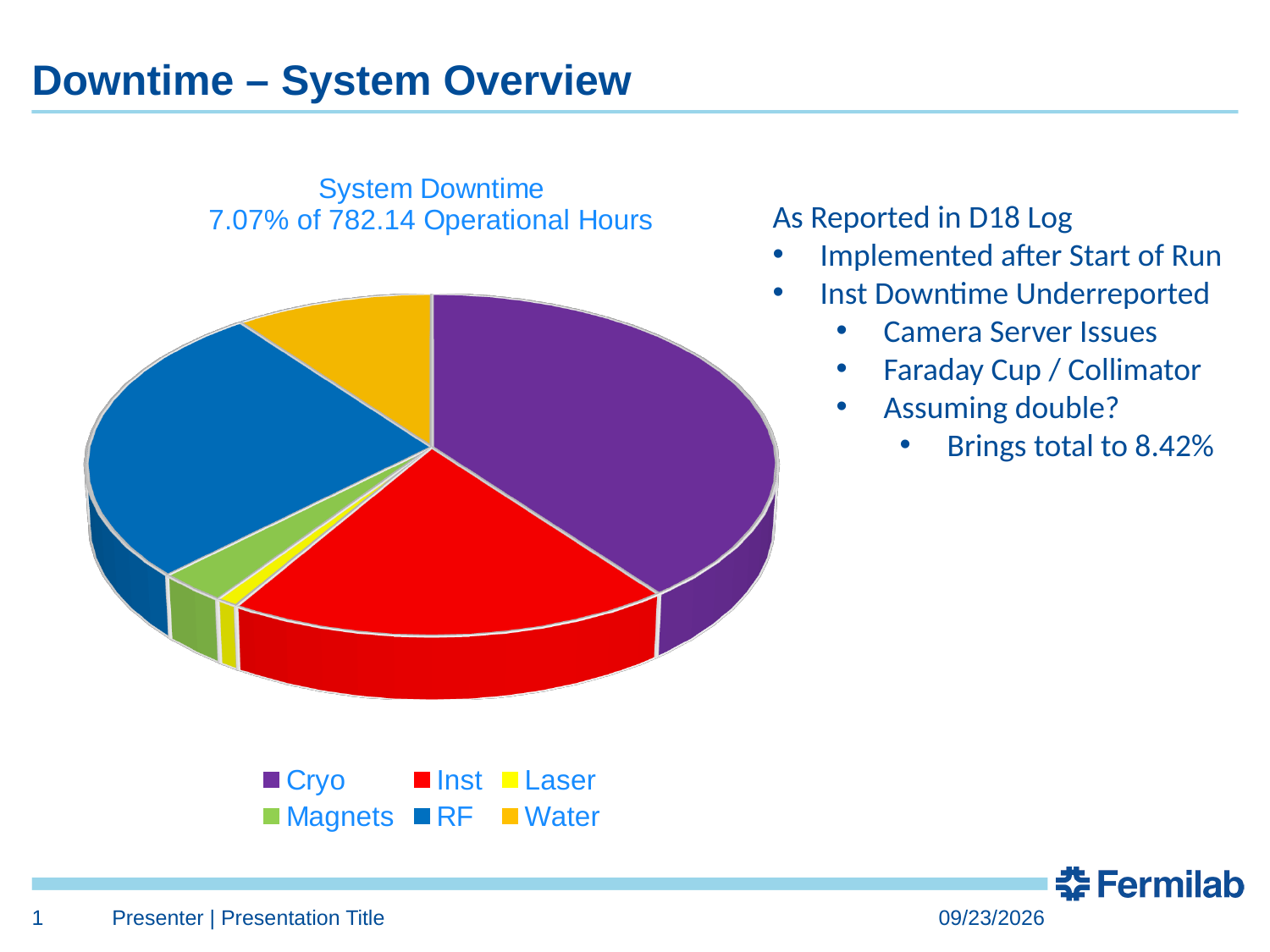
How many categories (slices) does the pie chart have? 6 What is the title of the pie chart? System Downtime 7.07% of 782.14 Operational Hours Which slice is larger in the pie chart, Water or Magnets? Water What kind of chart is shown on the slide? pie chart How many entries does the legend of the pie chart list? 6 What colour represents Cryo in the pie chart? purple Which slice is larger in the pie chart, Inst or Magnets? Inst Which slice is larger in the pie chart, RF or Laser? RF Which system accounts for the largest share of downtime in the pie chart? Cryo Which system accounts for the smallest share of downtime in the pie chart? Laser